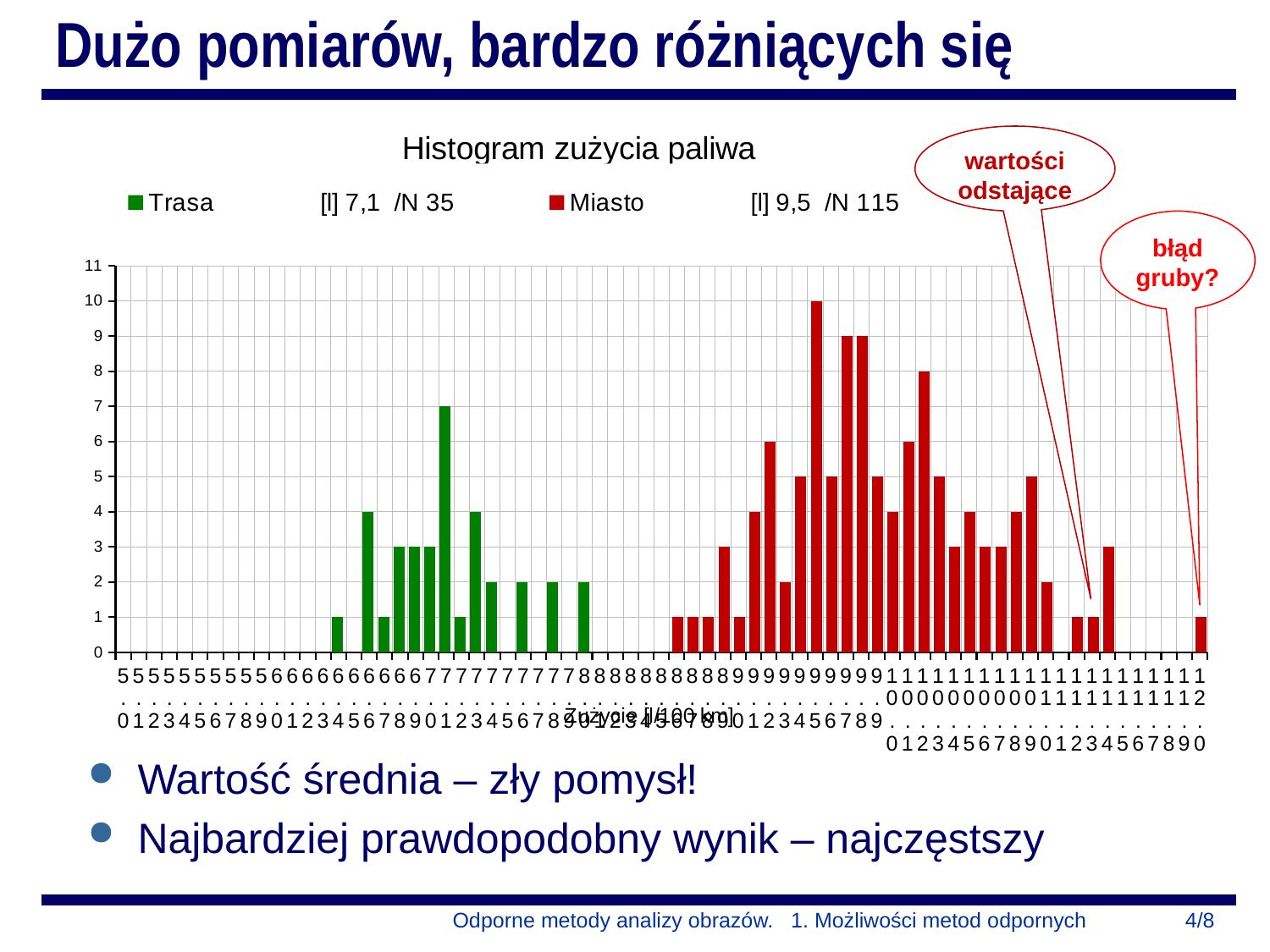
What N value is shown next to Miasto in the legend? 115 Which series has the taller highest bar, Trasa or Miasto? Miasto What is the height of the tallest bar in the Trasa series? 7 Is the tallest bar in the Miasto series greater or less than 8? greater What is the height of the tallest bar in the Miasto series? 10 Is the tallest bar in the Trasa series greater or less than 5? greater How many bars in the Miasto series reach a height of 9? 2 What is the difference between the tallest Miasto bar and the tallest Trasa bar? 3 What is the highest tick value shown on the vertical axis? 11 What is the title of the chart? Histogram zużycia paliwa How many series does the chart legend list? 2 What kind of chart is shown on the slide? bar chart